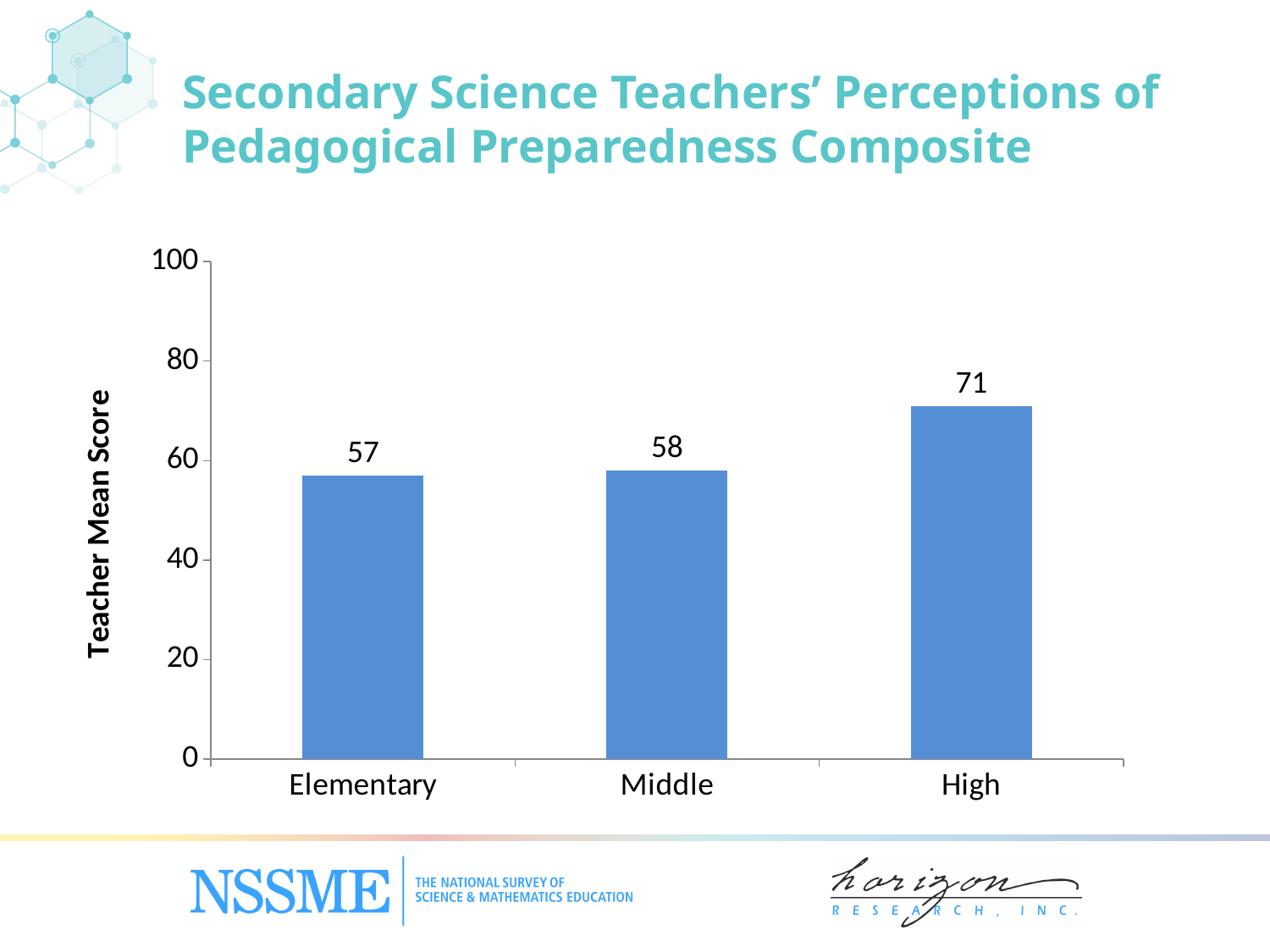
Which grade level has the highest teacher mean score? High What is the difference between the teacher mean scores for High and Middle? 13 What is the teacher mean score for Middle? 58 Which has a larger teacher mean score, Middle or High? High Which grade level has the lowest teacher mean score? Elementary What is the teacher mean score for High? 71 What is the teacher mean score for Elementary? 57 What kind of chart is shown on the slide? Bar chart What is the label of the vertical axis? Teacher Mean Score Is the value for High greater or less than 60? greater How many grade-level categories are shown on the chart? 3 What is the difference between the teacher mean scores for High and Elementary? 14